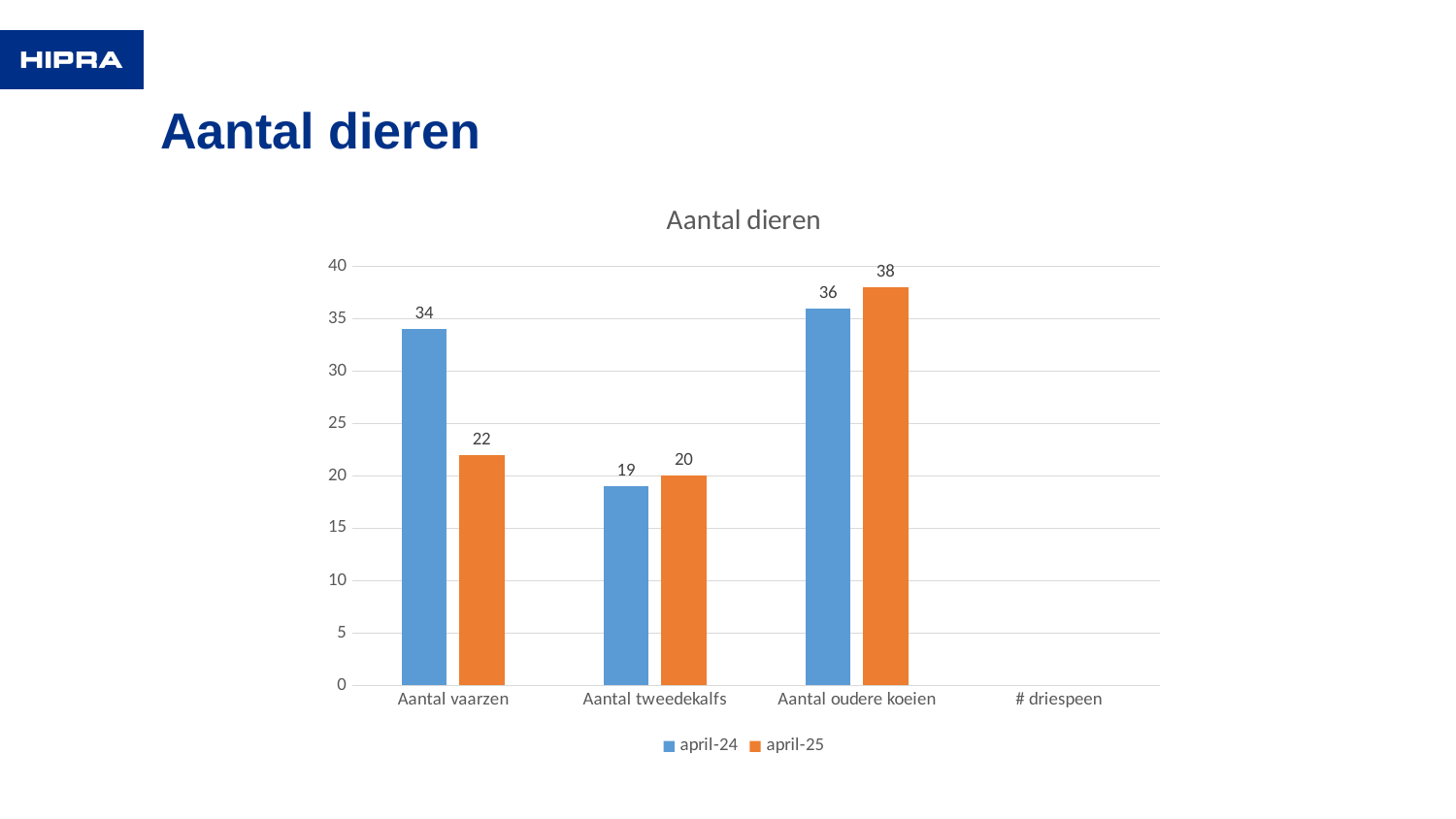
Which category has the highest value in the april-25 series? Aantal oudere koeien How many series does the legend list? 2 What is the value for Aantal vaarzen in the april-25 series? 22 How many categories are shown on the x axis? 4 Which is larger for Aantal oudere koeien: the april-24 value or the april-25 value? april-25 What is the difference between the april-24 and april-25 values for Aantal vaarzen? 12 What is the value for Aantal oudere koeien in the april-25 series? 38 Which category has the lowest value in the april-24 series? Aantal tweedekalfs What is the title of the chart? Aantal dieren What is the value for Aantal tweedekalfs in the april-24 series? 19 What kind of chart is shown on the slide? Bar chart What is the value for Aantal vaarzen in the april-24 series? 34